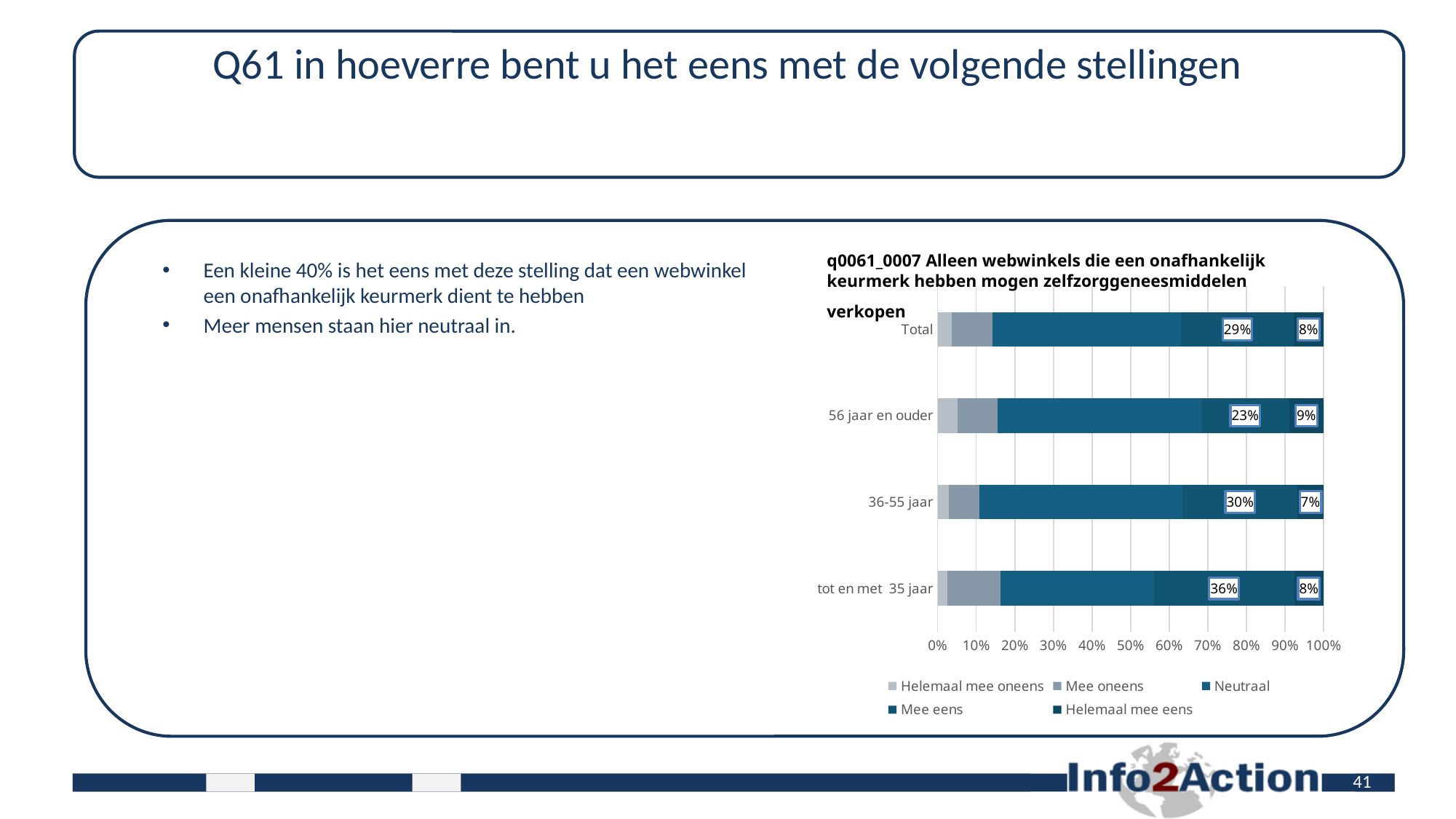
What is the value for 'Mee eens' for the 'Total' category? 29% What kind of chart is shown on the slide? Stacked bar chart How many series does the chart legend list? 5 Which category has the highest value for 'Mee eens'? tot en met 35 jaar What is the value for 'Mee eens' for '36-55 jaar'? 30% How many categories are shown on the y axis of the chart? 4 What is the value for 'Helemaal mee eens' for 'tot en met 35 jaar'? 8% Which category has the lowest value for 'Mee eens'? 56 jaar en ouder Which category has the lowest value for 'Helemaal mee eens'? 36-55 jaar What is the value for 'Helemaal mee eens' for '56 jaar en ouder'? 9% Which is larger: 'Mee eens' for '36-55 jaar' or 'Mee eens' for 'Total'? 36-55 jaar What is the difference in 'Mee eens' between 'tot en met 35 jaar' and '56 jaar en ouder'? 13 percentage points